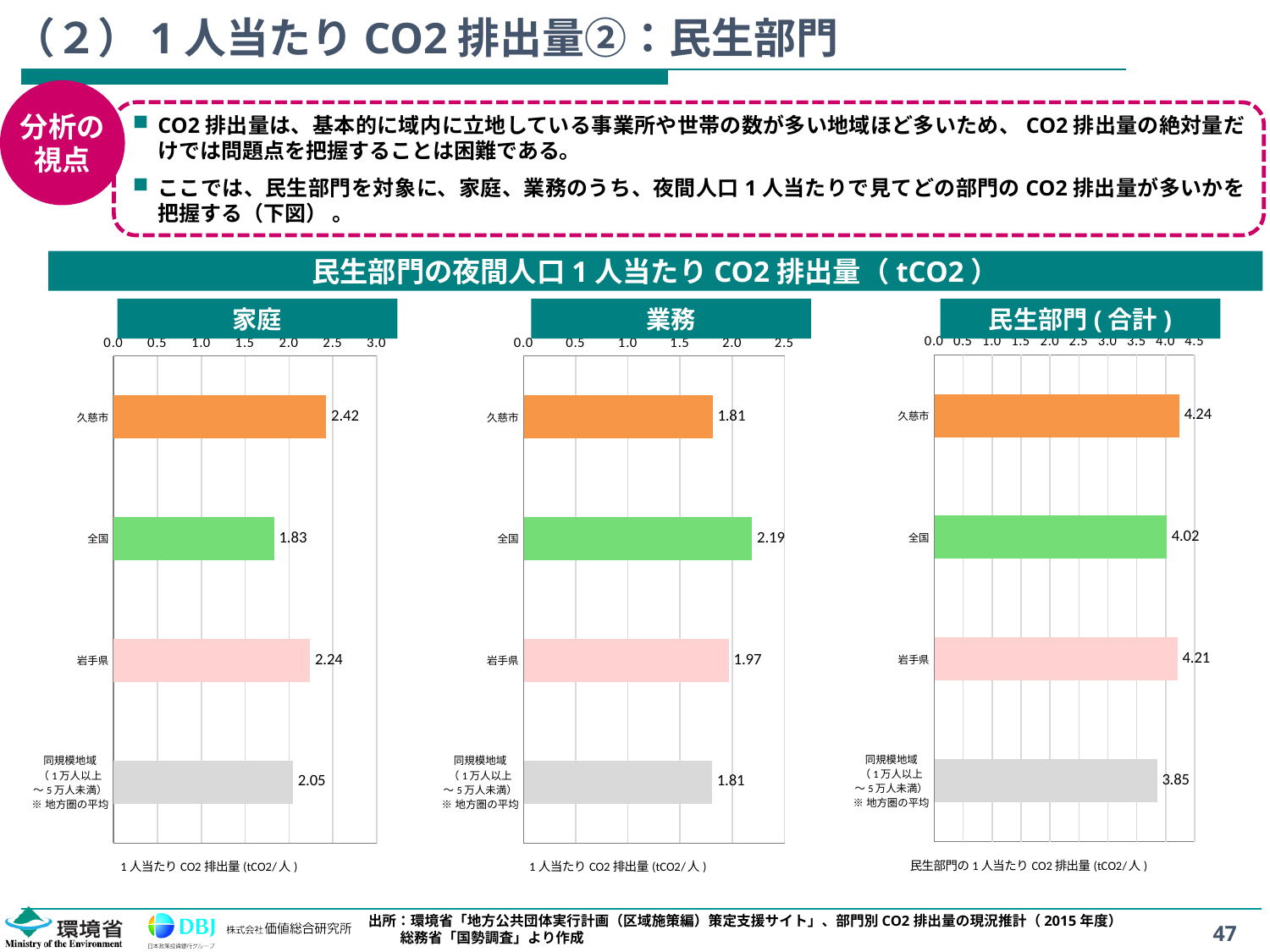
In the 業務 chart, what is the value for 全国? 2.19 In the 家庭 chart, what is the value for 久慈市? 2.42 In the 業務 chart, which is larger, the value for 岩手県 or the value for 久慈市? 岩手県 What type of chart is the 業務 chart? bar chart In the 業務 chart, which category has the highest value? 全国 In the 民生部門(合計) chart, what is the value for 岩手県? 4.21 In the 民生部門(合計) chart, is the value for 同規模地域 greater or less than 4.0? less In the 民生部門(合計) chart, which category has the lowest value? 同規模地域 In the 家庭 chart, what is the difference between the values for 久慈市 and 全国? 0.59 How many categories are shown in the 家庭 chart? 4 In the 民生部門(合計) chart, what is the difference between the values for 久慈市 and 同規模地域? 0.39 In the 家庭 chart, which category has the highest value? 久慈市